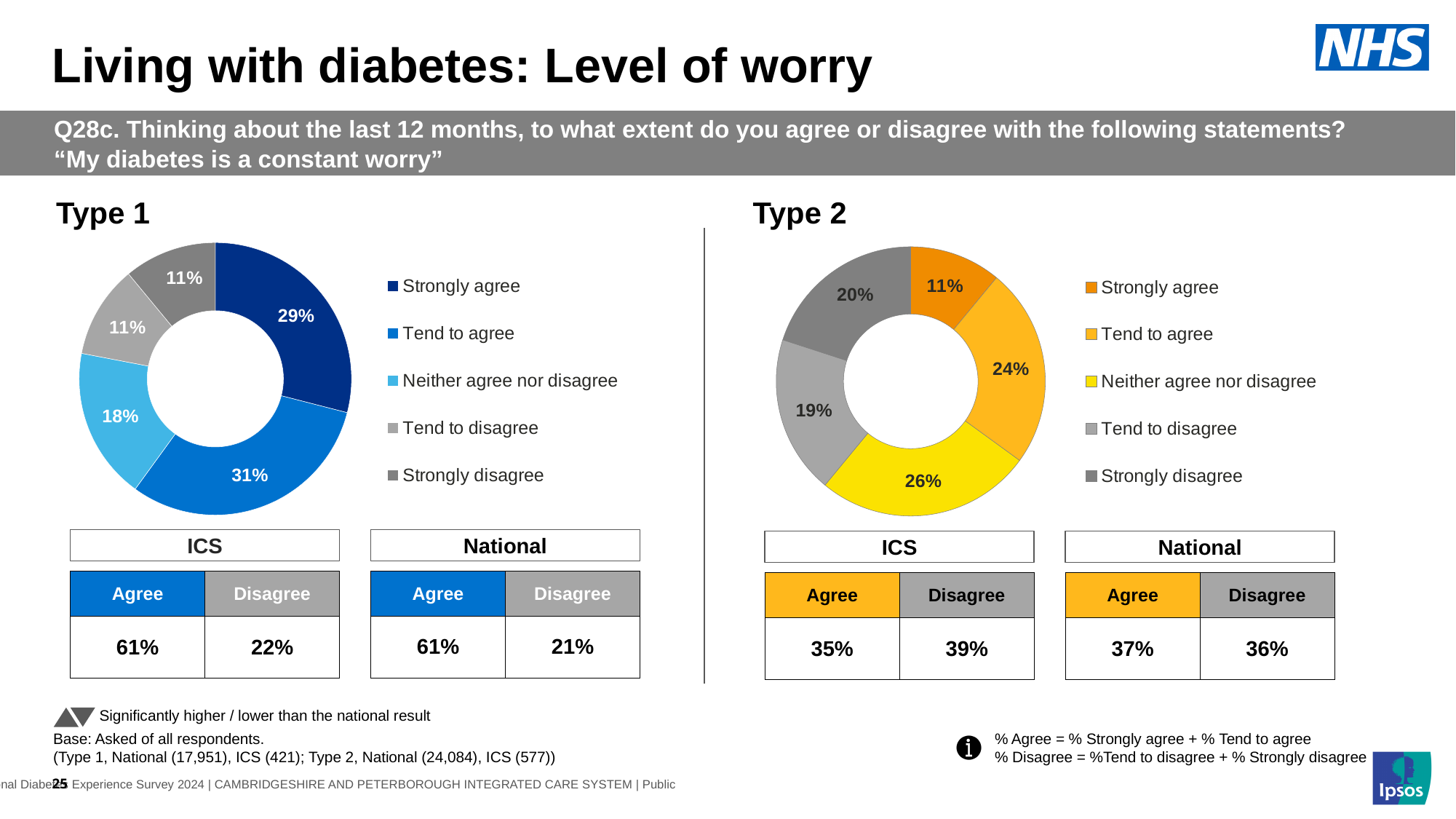
What is the difference between the Tend to agree share in the Type 1 chart and the Tend to agree share in the Type 2 chart? 7 percentage points What type of chart is used for Type 1? Donut chart In the Type 2 chart, which response category has the largest share? Neither agree nor disagree How many response categories does the legend of the Type 1 chart list? 5 In the Type 2 chart, what percentage of respondents said they strongly disagree? 20% In the Type 2 chart, what colour is the Neither agree nor disagree segment? Yellow In the Type 1 chart, what percentage of respondents said they strongly agree? 29% In the Type 1 chart, what percentage of respondents said they tend to agree? 31% In the Type 2 chart, what percentage of respondents said they neither agree nor disagree? 26% In the Type 2 chart, which response category has the smallest share? Strongly agree In the Type 2 chart, which is larger: the Tend to disagree share or the Strongly disagree share? Strongly disagree In the Type 1 chart, which response category has the largest share? Tend to agree